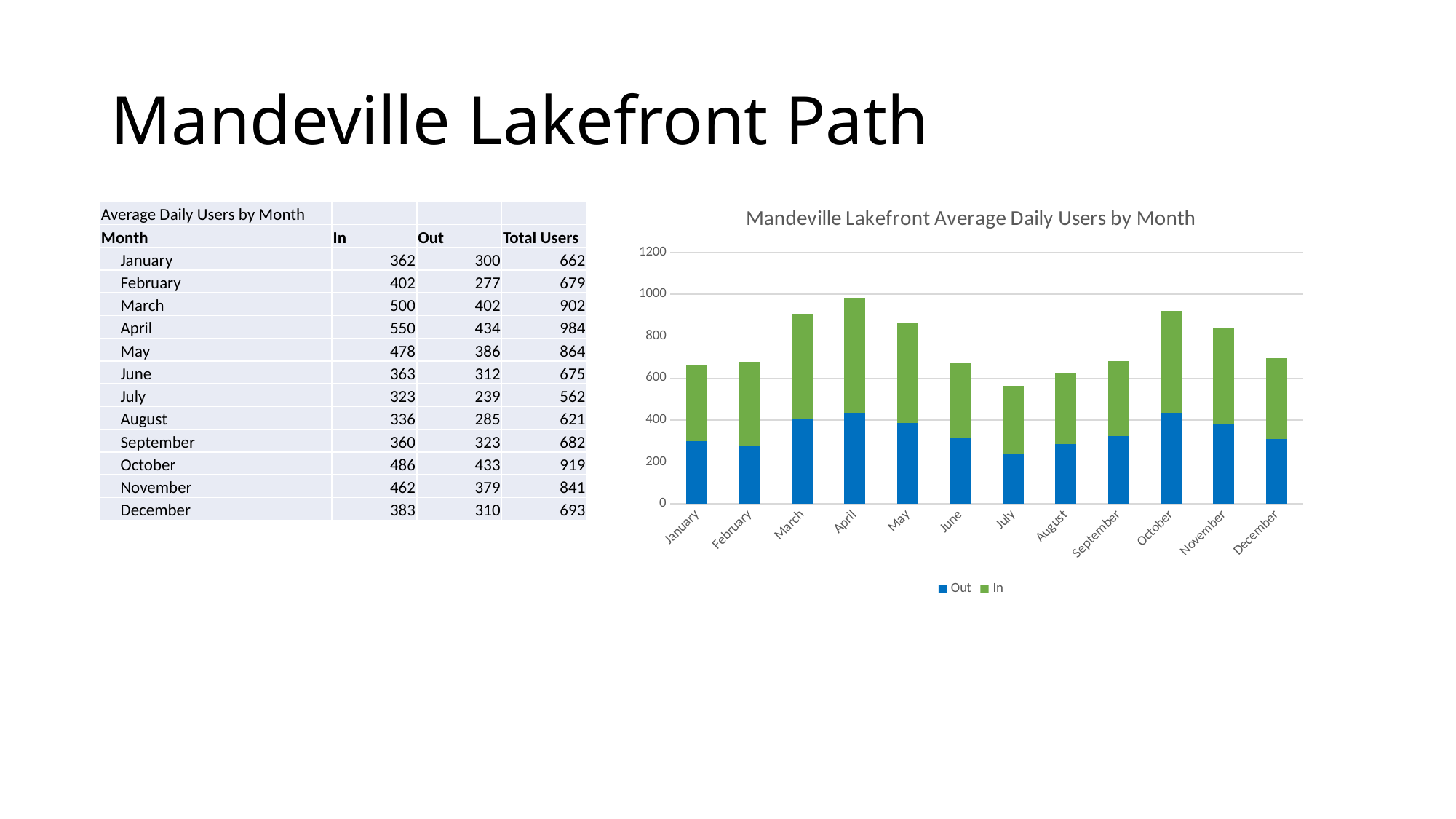
Which is larger, the total stacked bar for October or for November? October What kind of chart is shown on the slide? stacked bar chart What is the total of the stacked bar for April? 984 How many series does the chart legend list? 2 Which month has the shortest stacked bar in the chart? July Which month has the tallest stacked bar in the chart? April How many months are plotted along the x axis of the chart? 12 What is the title of the chart? Mandeville Lakefront Average Daily Users by Month Is the total stacked bar for July greater or less than 600? less What is the difference between the total users for April and the total users for July? 422 What is the In value for March? 500 What is the Out value for October? 433